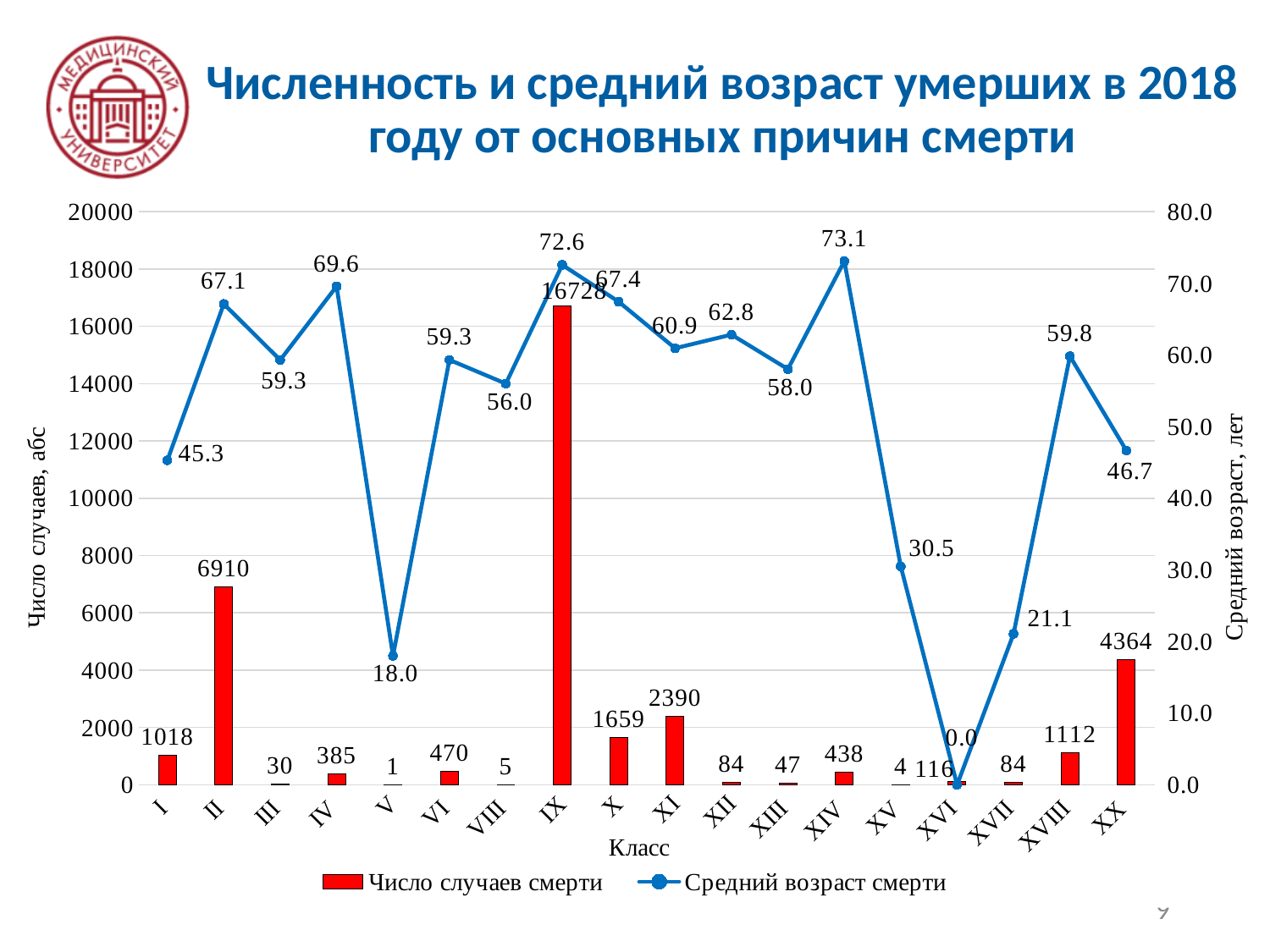
What is the label of the right-hand vertical axis? Средний возраст, лет What is the number of deaths (Число случаев смерти) for class IX? 16728 What is the average age of death for class V? 18.0 What is the difference in the number of deaths between class II and class XI? 4520 Which class has the highest number of deaths? IX Which class has the lowest average age of death? XVI What kind of chart is used for the series 'Число случаев смерти'? bar chart How many series does the legend list? 2 Which has a higher average age of death, class IV or class X? IV How many classes are shown on the x axis? 18 What is the number of deaths for class XX? 4364 What is the average age of death (Средний возраст смерти) for class XIV? 73.1